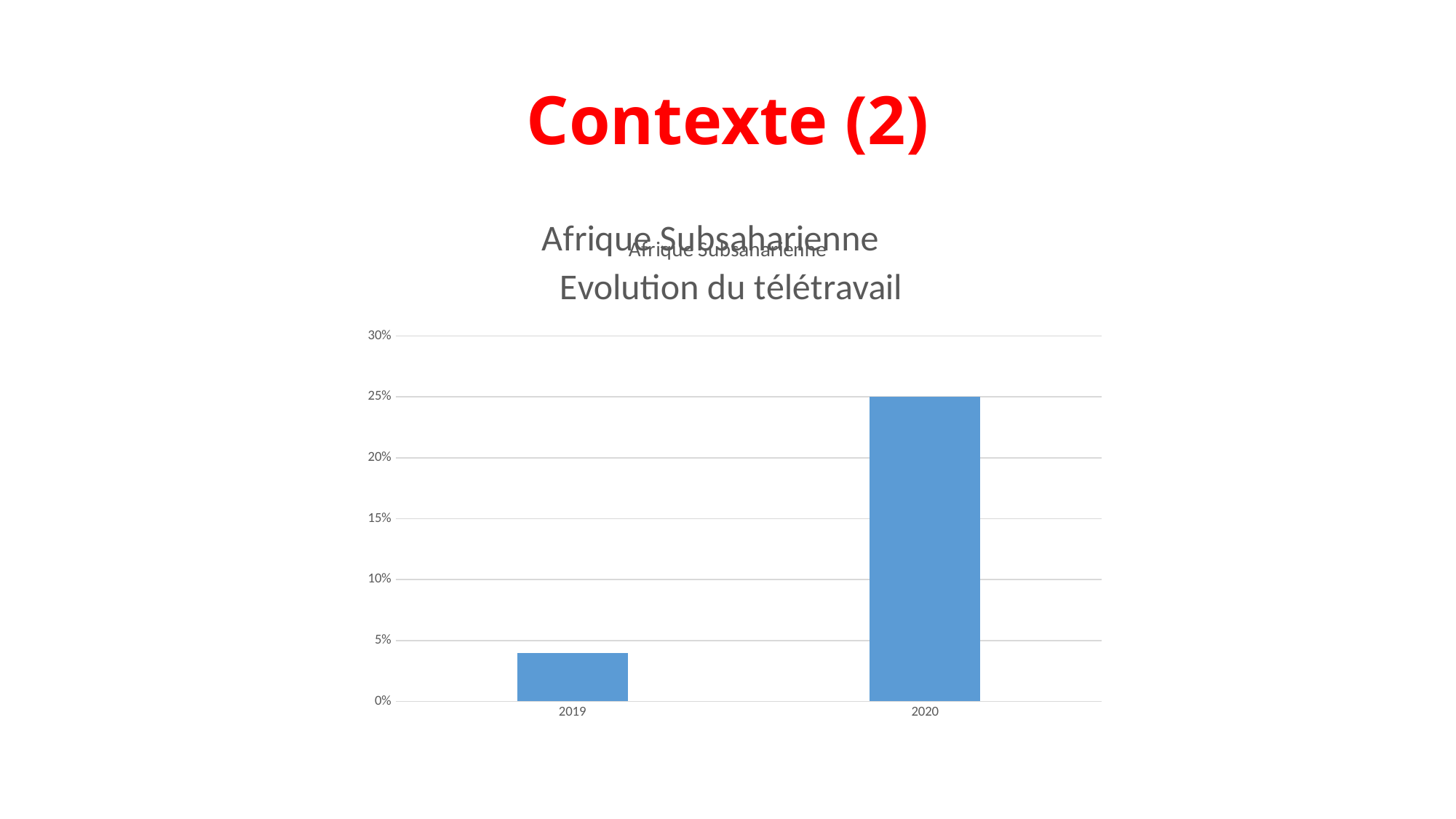
Is the value for 2019 greater or less than 5%? less Which year has the lowest value in the chart? 2019 What colour are the bars in the chart? blue Which is larger, the value for 2019 or the value for 2020? 2020 What is the value for 2020 in the chart? 25% Which year has the highest value in the chart? 2020 What is the title of the chart? Afrique Subsaharienne Evolution du télétravail How many categories are plotted on the x axis of the chart? 2 Do the values rise or fall from 2019 to 2020? rise Is the value for 2020 greater or less than 20%? greater Is the value for 2019 greater or less than 10%? less What kind of chart is shown on the slide? bar chart